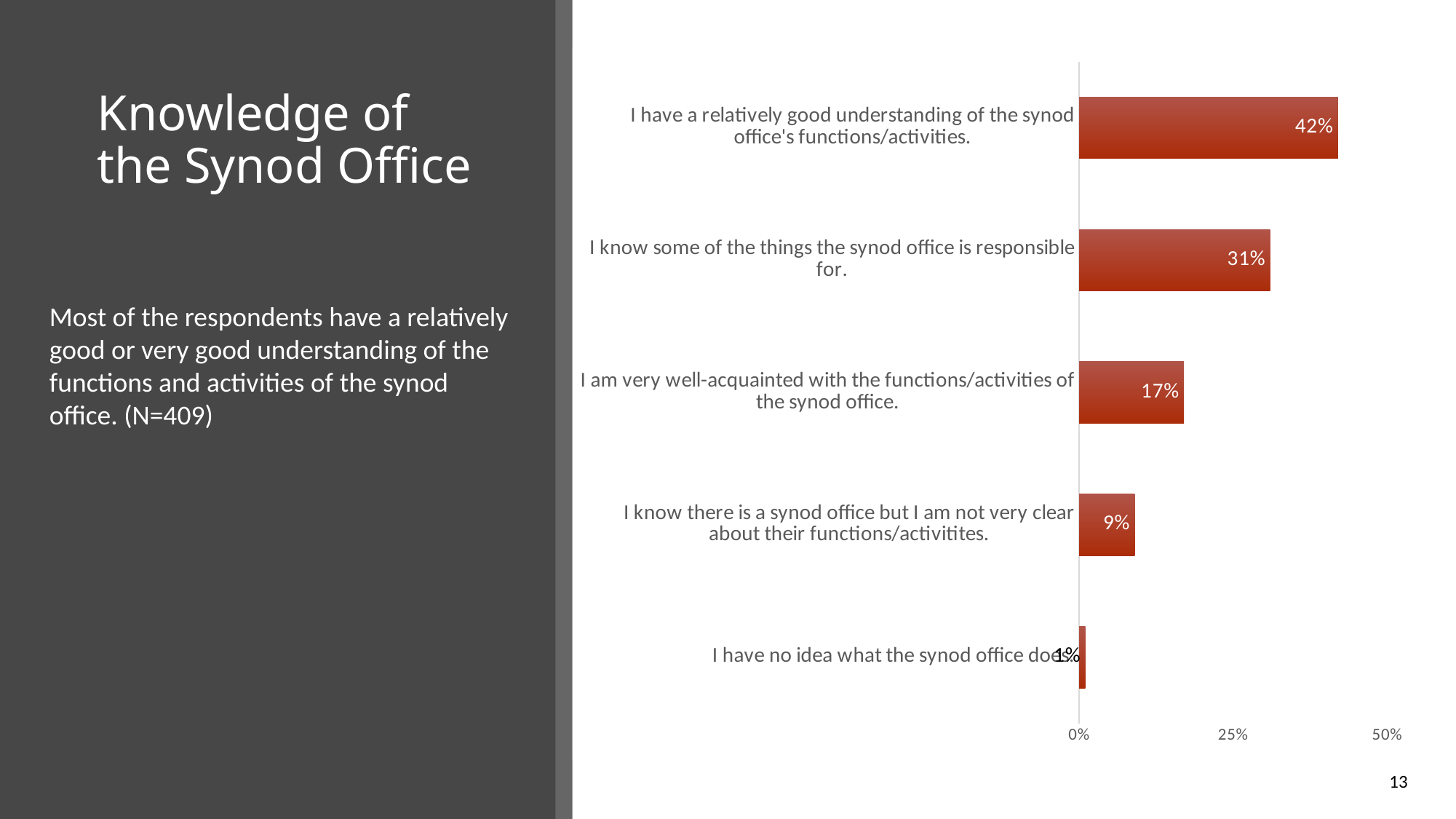
What percentage of respondents said they are very well-acquainted with the functions/activities of the synod office? 17% What type of chart is shown on the slide? Bar chart Is the value for 'I have a relatively good understanding of the synod office's functions/activities' greater or less than 25%? greater What is the difference in percentage points between 'I have a relatively good understanding' and 'I know some of the things the synod office is responsible for'? 11 What percentage of respondents said they know there is a synod office but are not very clear about its functions/activities? 9% Which response category has the lowest percentage? I have no idea what the synod office does. Which response category has the highest percentage? I have a relatively good understanding of the synod office's functions/activities. What percentage of respondents said they know some of the things the synod office is responsible for? 31% How many response categories are shown in the chart? 5 What percentage of respondents said they have a relatively good understanding of the synod office's functions/activities? 42% What is the title of the slide containing the chart? Knowledge of the Synod Office Which is larger: the percentage for 'I am very well-acquainted with the functions/activities of the synod office' or for 'I know there is a synod office but I am not very clear about their functions/activities'? I am very well-acquainted with the functions/activities of the synod office.